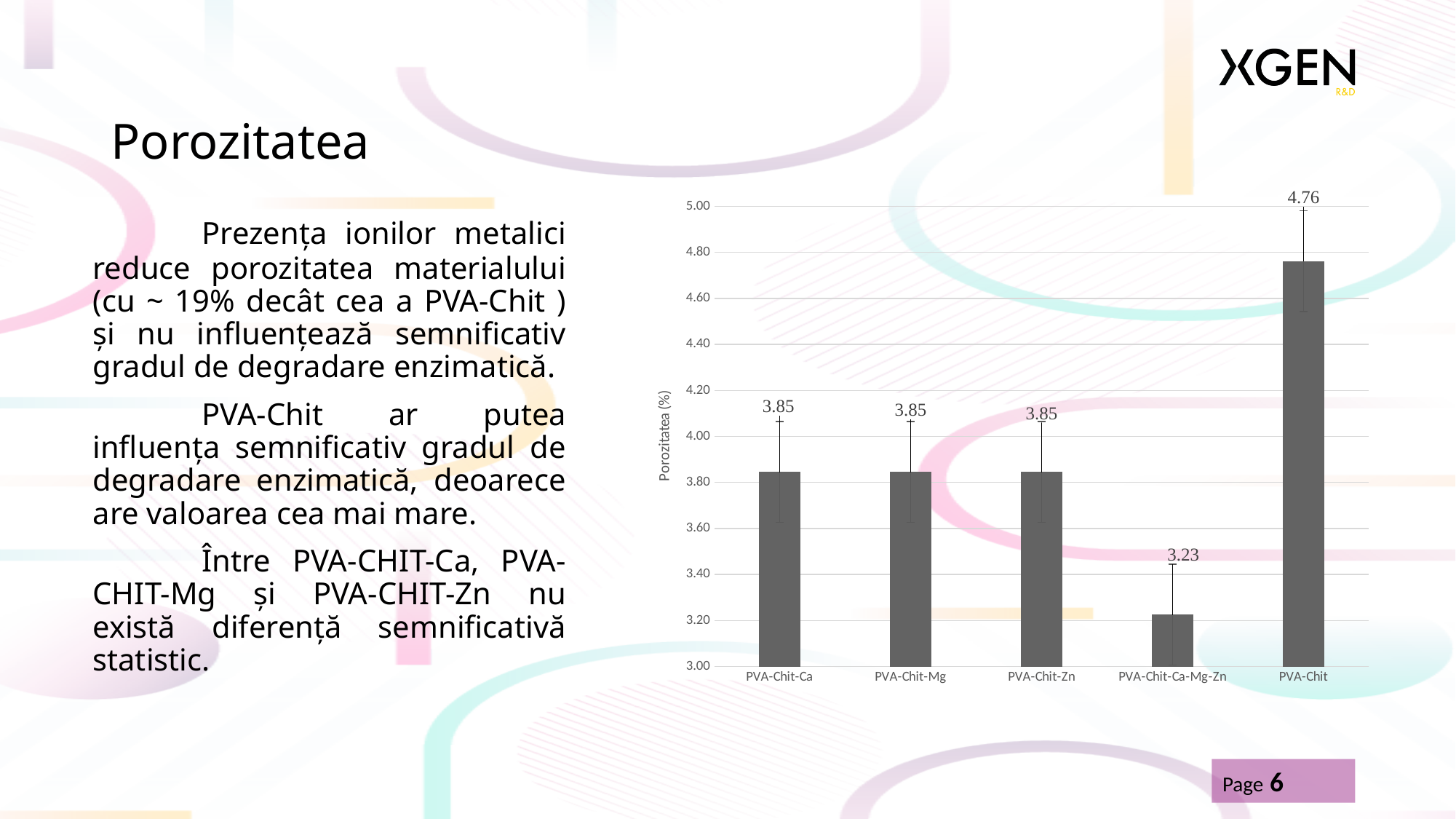
What is the difference between the porosity of PVA-Chit-Mg and PVA-Chit-Ca-Mg-Zn? 0.62 What is the porosity value for PVA-Chit-Ca? 3.85 Is the value for PVA-Chit-Ca-Mg-Zn greater or less than 3.40? less What is the label of the vertical axis of the chart? Porozitatea (%) What is the porosity value for PVA-Chit-Ca-Mg-Zn? 3.23 Which category has the lowest porosity? PVA-Chit-Ca-Mg-Zn Which category has the highest porosity? PVA-Chit What kind of chart is shown on the slide? bar chart What is the porosity value for PVA-Chit? 4.76 How many categories are shown on the x axis of the chart? 5 What is the difference between the porosity of PVA-Chit and PVA-Chit-Zn? 0.91 Which has a larger porosity value, PVA-Chit-Ca-Mg-Zn or PVA-Chit? PVA-Chit